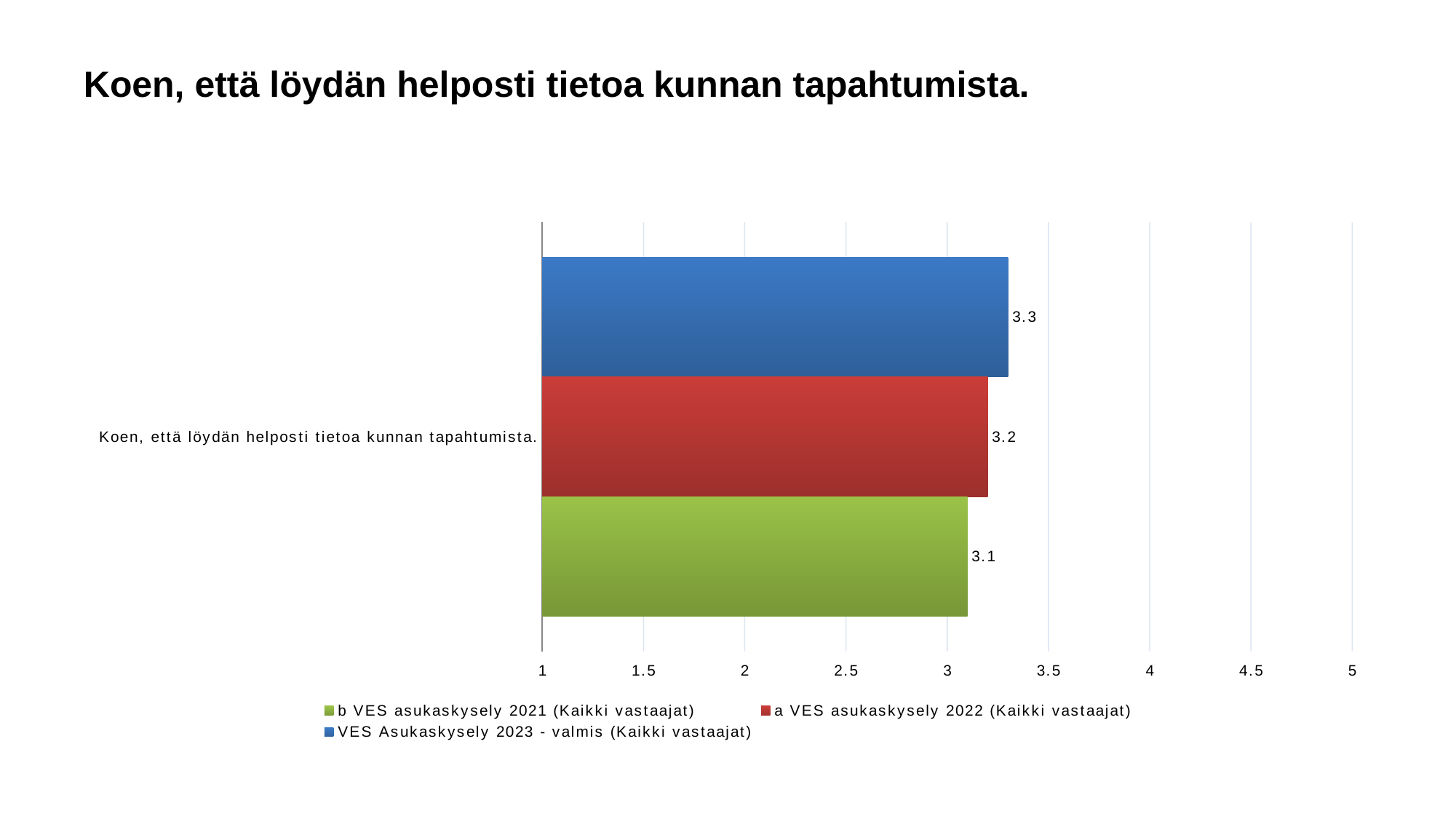
What colour is the bar for the 2022 series? red Which series has the highest value? VES Asukaskysely 2023 - valmis (Kaikki vastaajat) How many series does the legend list? 3 What is the value for the 'a VES asukaskysely 2022 (Kaikki vastaajat)' series? 3.2 What is the value for the 'b VES asukaskysely 2021 (Kaikki vastaajat)' series? 3.1 Which series has the lowest value? b VES asukaskysely 2021 (Kaikki vastaajat) Do the values rise or fall from the 2021 survey to the 2023 survey? rise Which is larger, the value for 2022 or the value for 2021? 2022 Is the value for the 2023 series greater or less than 3.5? less What is the value for the 'VES Asukaskysely 2023 - valmis (Kaikki vastaajat)' series? 3.3 What kind of chart is shown on the slide? bar chart What is the difference between the 2023 value and the 2021 value? 0.2